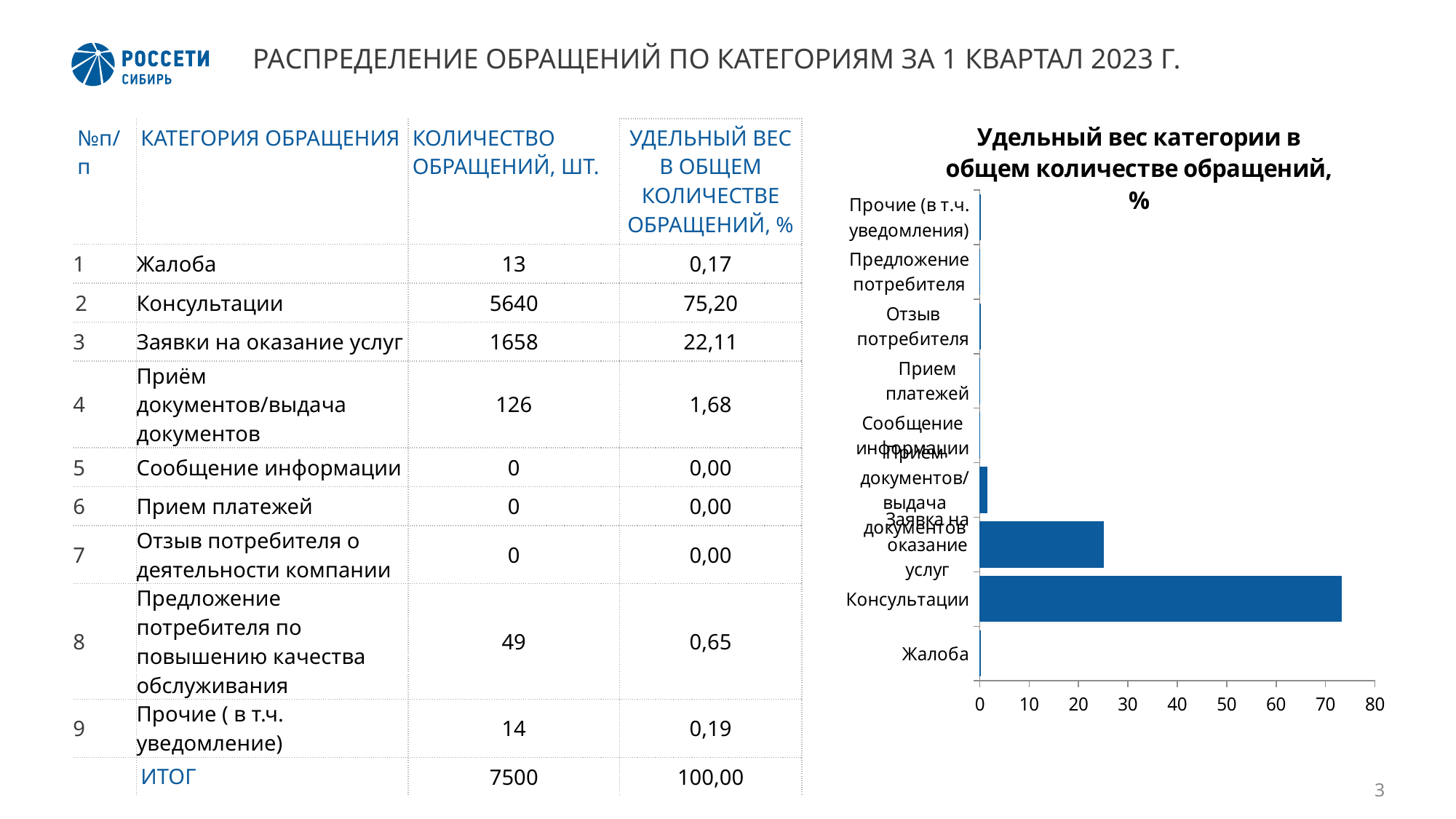
How many categories are plotted in the chart? 9 What is the title of the chart? Удельный вес категории в общем количестве обращений, % Is the value for Заявка на оказание услуг greater or less than 20? greater Is the value for Приём документов/выдача документов greater or less than 10? less Is the value for Заявка на оказание услуг greater or less than 30? less Which is larger, the value for Заявка на оказание услуг or the value for Приём документов/выдача документов? Заявка на оказание услуг What is the highest value shown on the chart's horizontal axis? 80 What kind of chart is shown on the slide? bar chart Which is larger, the value for Консультации or the value for Заявка на оказание услуг? Консультации Which is larger, the value for Приём документов/выдача документов or the value for Жалоба? Приём документов/выдача документов Which category has the highest value in the chart? Консультации